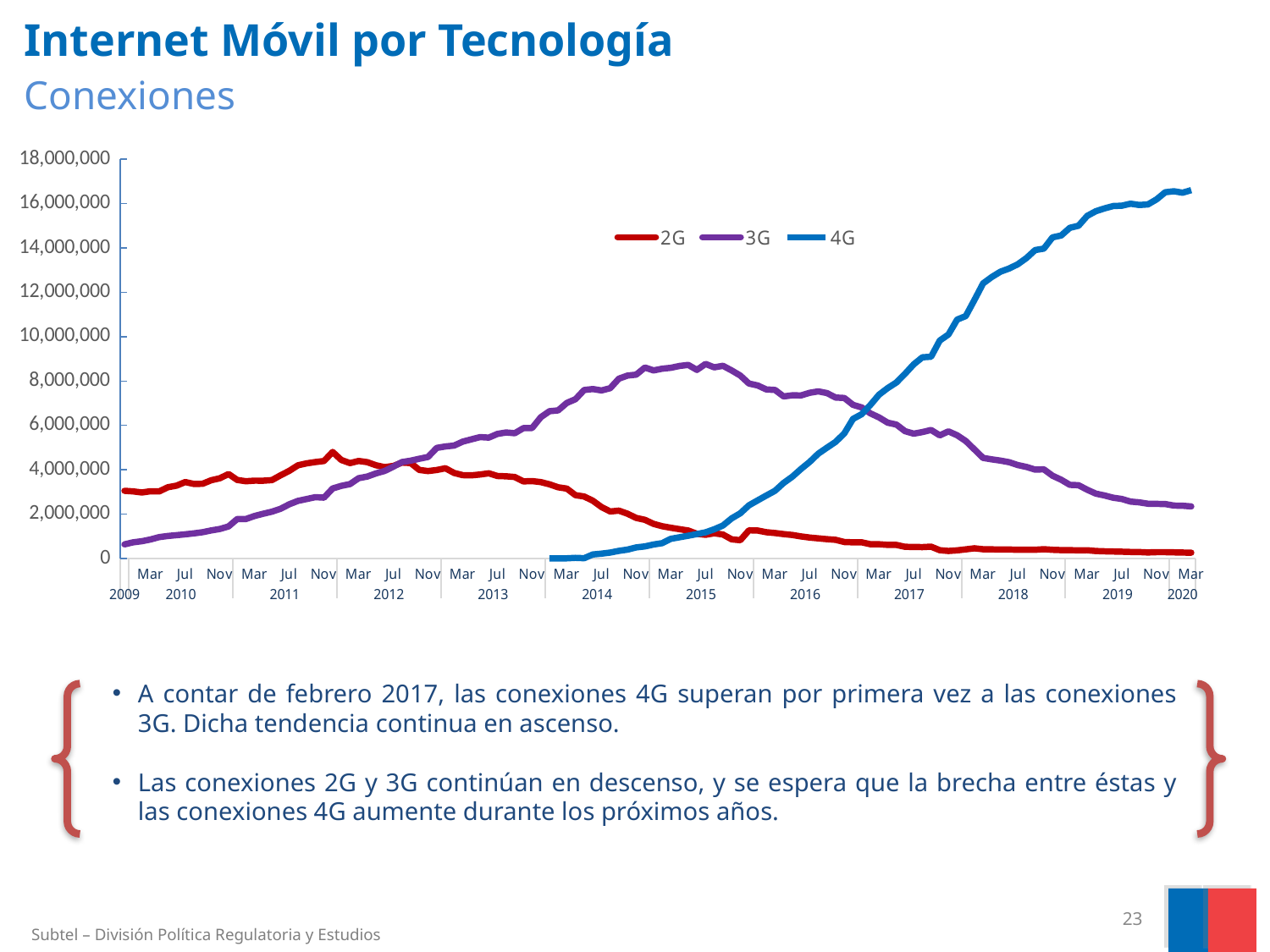
What colour is the 4G line in the chart? Blue Which is larger at the start of the chart in 2009, the 2G series or the 3G series? 2G Does the 2G series rise or fall from 2012 to 2020? Fall Is the value for 2G in Mar 2020 greater or less than 2,000,000? less Is the value for 3G in Mar 2020 greater or less than 4,000,000? less Which series has the highest value at the end of the chart (Mar 2020)? 4G Which is larger in Mar 2015, the 3G series or the 2G series? 3G Does the 4G series rise or fall from 2014 to 2020? Rise What kind of chart is shown on the slide? Line chart Which series has the lowest value at the end of the chart (Mar 2020)? 2G How many series does the chart legend list? 3 Is the value for 4G in Mar 2020 greater or less than 14,000,000? greater